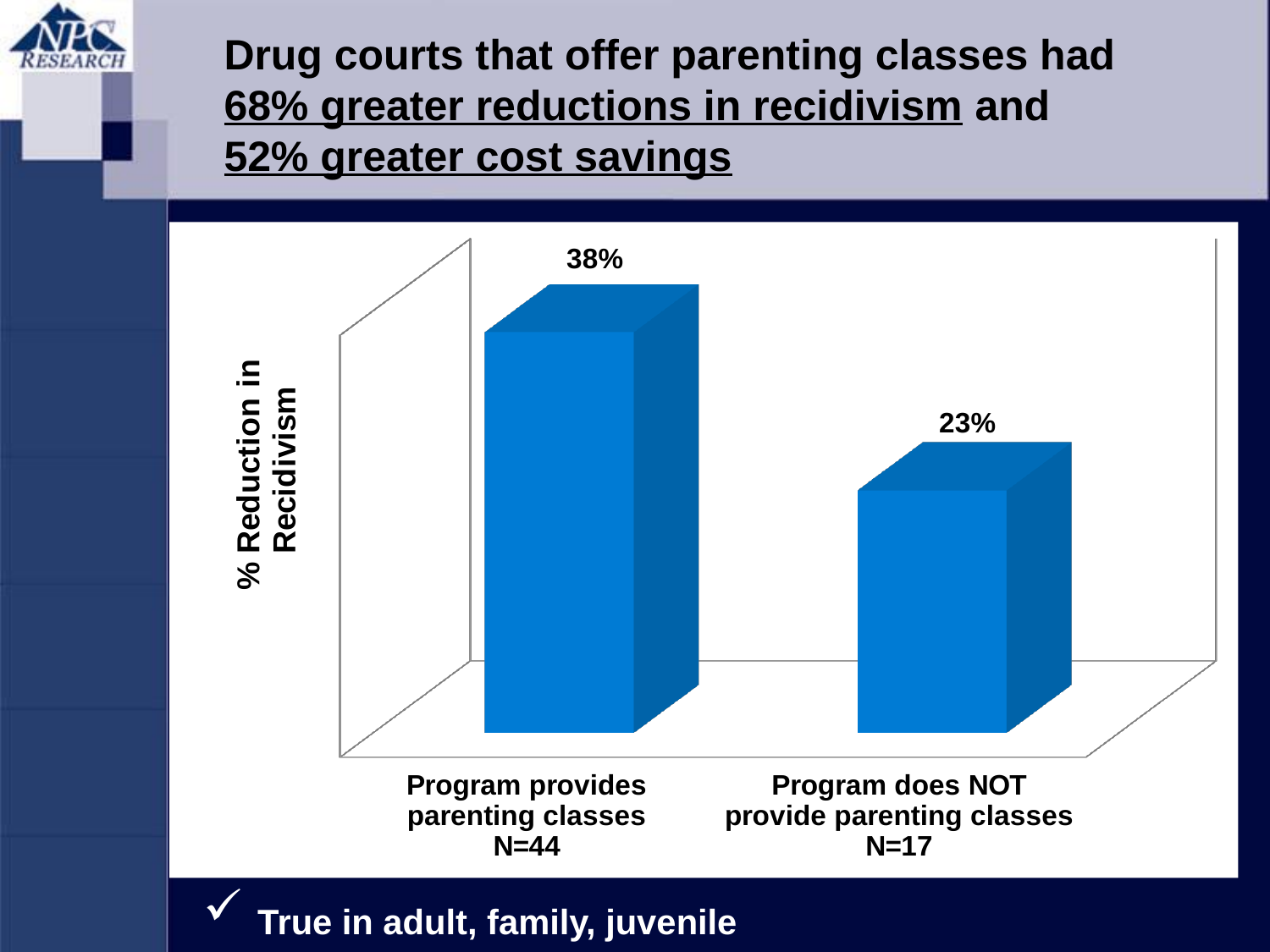
What is the % reduction in recidivism for programs that provide parenting classes? 38% Which category has the higher % reduction in recidivism? Program provides parenting classes Which category has the lower % reduction in recidivism? Program does NOT provide parenting classes What is the difference in % reduction in recidivism between programs that provide parenting classes and those that do not? 15% What is the label of the vertical axis of the chart? % Reduction in Recidivism How many categories are shown in the chart? 2 What is the % reduction in recidivism for programs that do NOT provide parenting classes? 23% Is the % reduction in recidivism larger for programs that provide parenting classes or for programs that do not? Program provides parenting classes What kind of chart is shown on the slide? Bar chart What is the sample size (N) for the programs that provide parenting classes? N=44